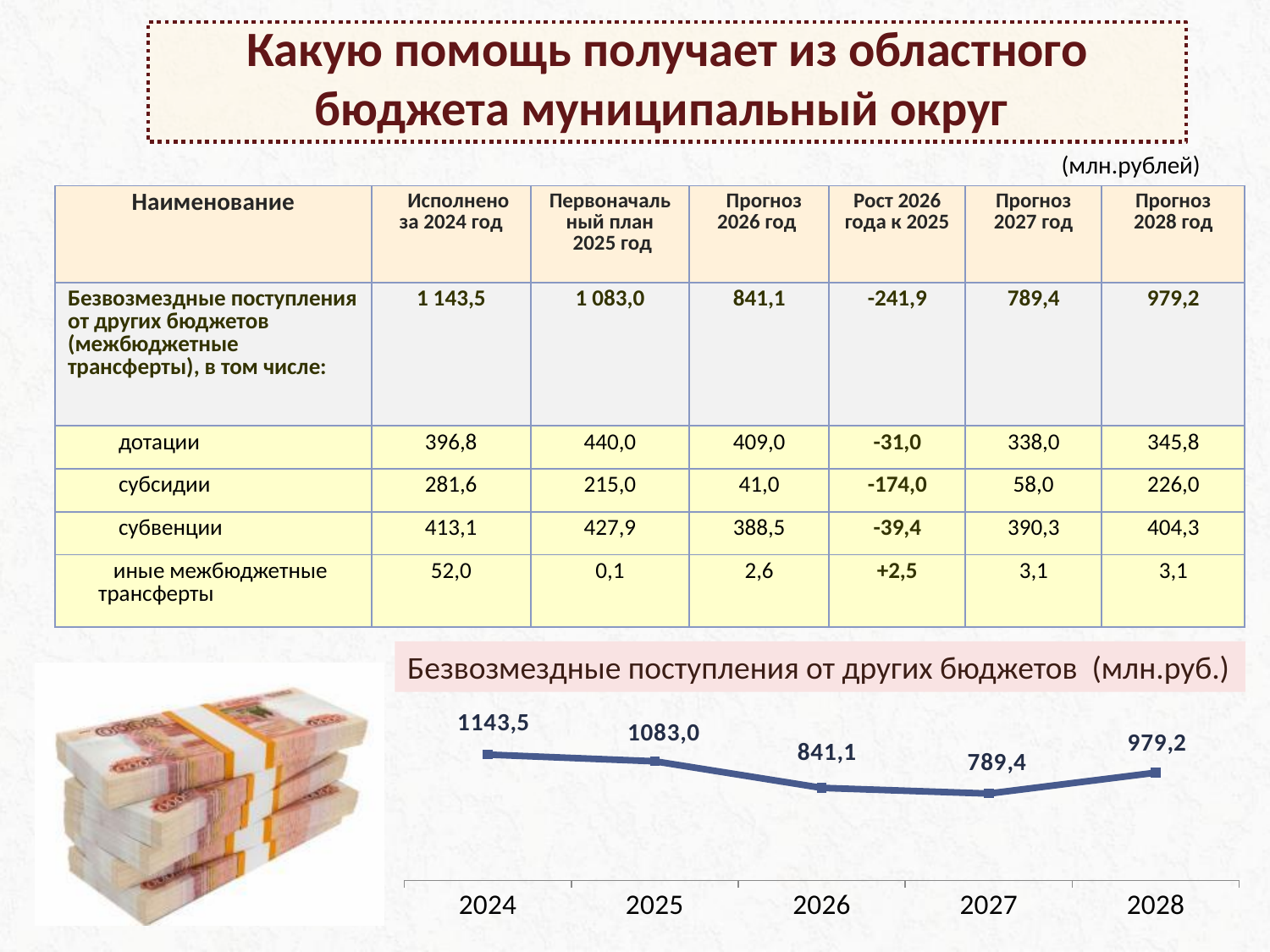
В каком году на графике безвозмездных поступлений значение наименьшее? 2027 Как называется график в нижней части слайда? Безвозмездные поступления от других бюджетов (млн.руб.) Какое значение показано на графике для 2028 года? 979,2 Сколько точек (лет) показано на графике безвозмездных поступлений? 5 На сколько значение 2028 года на графике больше значения 2027 года? 189,8 Какое значение на графике больше: за 2025 год или за 2028 год? 2025 год Какое значение показано на графике для 2026 года? 841,1 На сколько значение 2025 года на графике больше значения 2026 года? 241,9 В каком году на графике безвозмездных поступлений значение наибольшее? 2024 Какое значение показано на графике «Безвозмездные поступления от других бюджетов» для 2024 года? 1143,5 Какого типа диаграмма расположена в нижней части слайда? Линейный график Как меняются значения на графике с 2024 по 2027 год? Снижаются